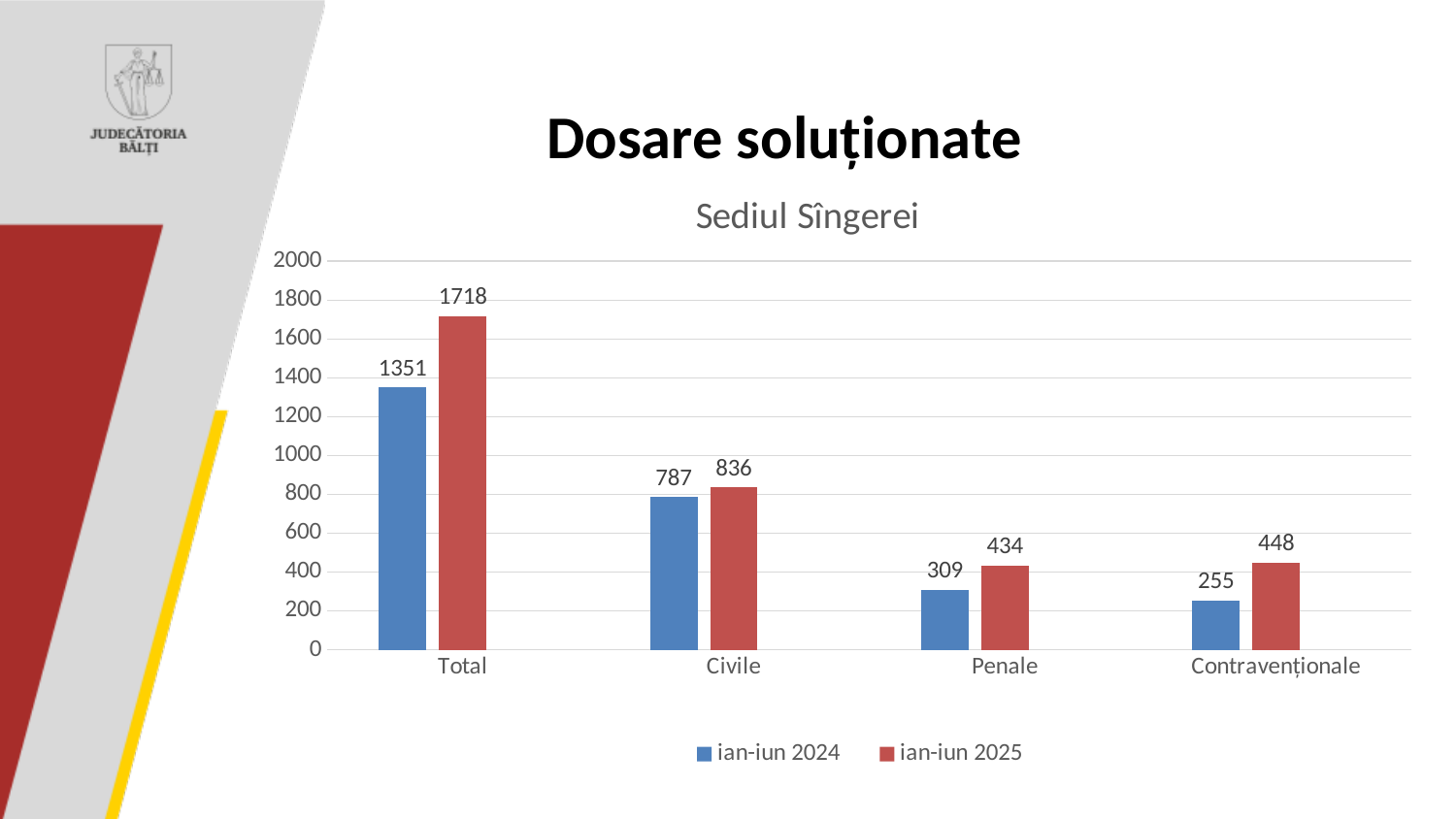
What is the difference between the ian-iun 2025 and ian-iun 2024 values for Civile? 49 Which category has the lowest value in the ian-iun 2024 series? Contravenționale What is the value for Penale in the ian-iun 2024 series? 309 What kind of chart is shown on the slide? Bar chart How many series does the legend list? 2 Which is larger: the ian-iun 2024 value for Penale or the ian-iun 2024 value for Contravenționale? Penale How many categories are shown on the x axis? 4 What is the value for Contravenționale in the ian-iun 2025 series? 448 What is the difference between the ian-iun 2025 and ian-iun 2024 values for Total? 367 What is the value for Total in the ian-iun 2025 series? 1718 What is the title of the chart? Sediul Sîngerei Which category has the highest value in the ian-iun 2025 series? Total